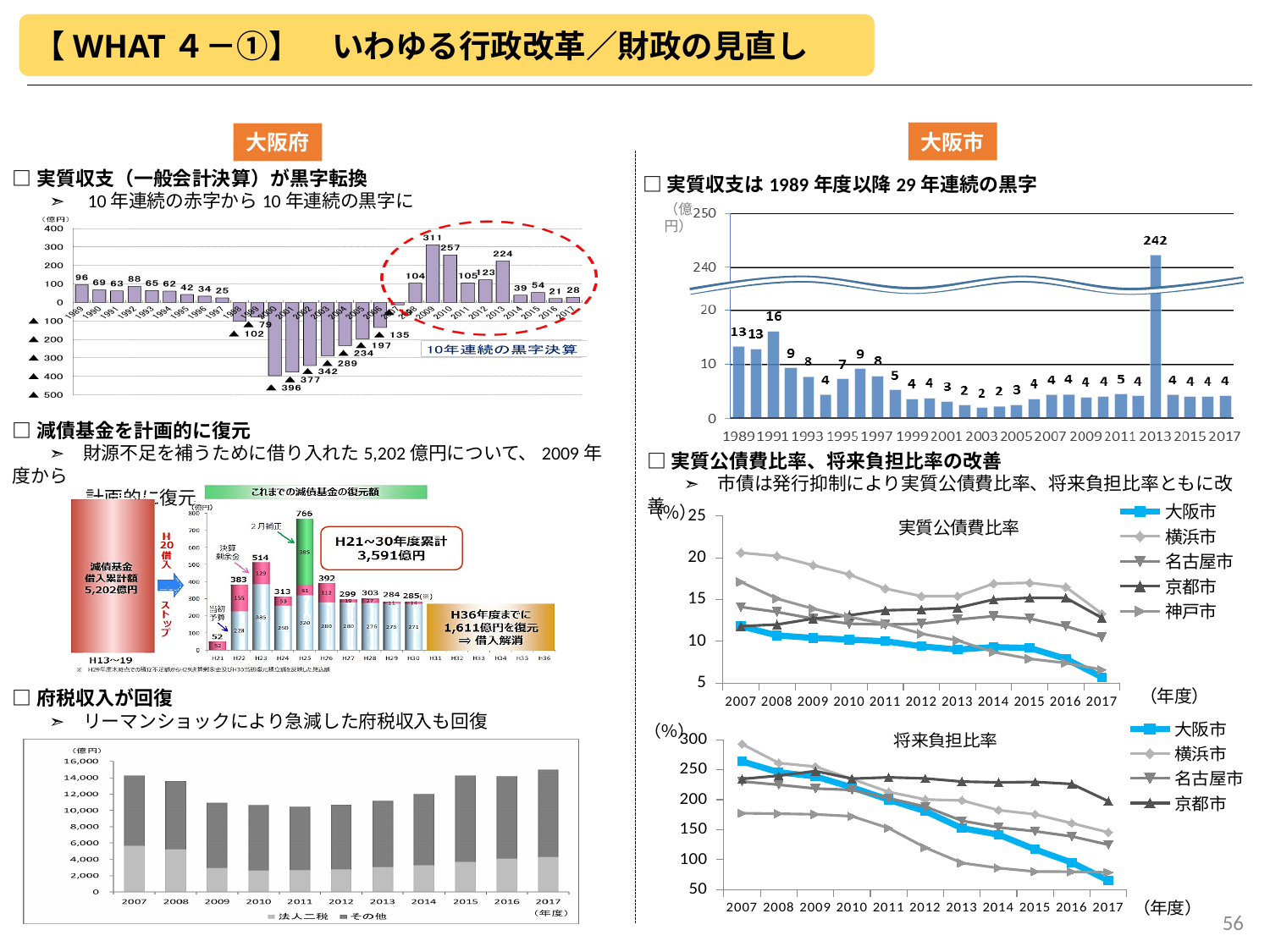
In the 大阪市 実質収支 bar chart (top right), which year has the highest value? 2013 What kind of chart is the 府税収入 chart at the bottom left? bar chart How many series does the legend of the 実質公債費比率 line chart (middle right) list? 5 In the 大阪市 実質収支 bar chart (top right), what is the value for 1991? 16 In the 実質公債費比率 line chart (middle right), which city has the highest value in 2007? 横浜市 In the 大阪府 実質収支 bar chart (top left), which year has the lowest value? 2001 In the 大阪府 実質収支 bar chart (top left), what is the value for 2009? 311 In the 実質公債費比率 line chart (middle right), is the value for 大阪市 in 2017 greater or less than 10? less In the 将来負担比率 line chart (bottom right), does the value for 大阪市 rise or fall from 2007 to 2017? fall In the 大阪市 実質収支 bar chart (top right), what is the value for 2013? 242 In the 大阪府 実質収支 bar chart (top left), what is the difference between the 2009 value and the 2010 value? 54